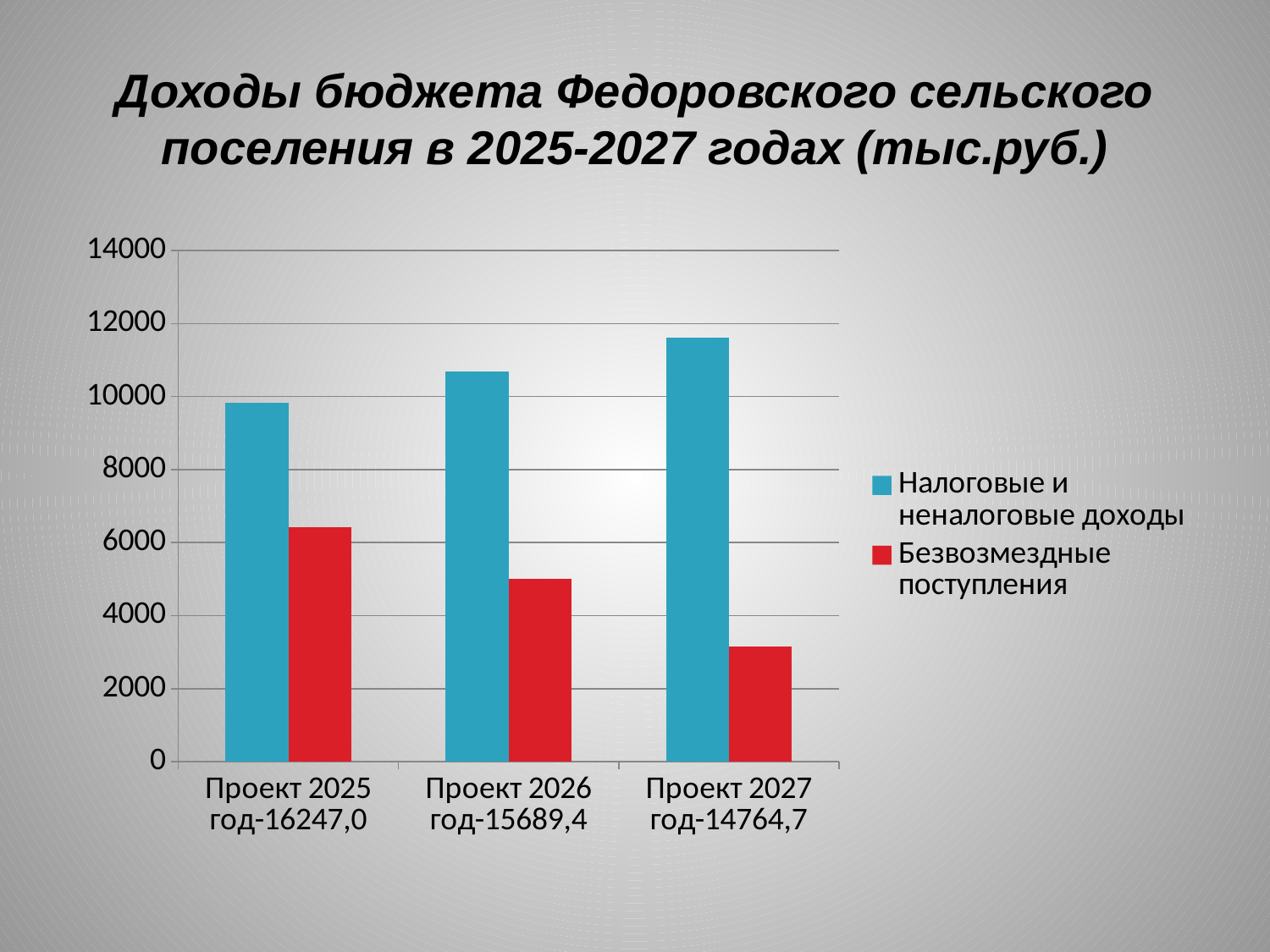
Do the values for Безвозмездные поступления rise or fall from Проект 2025 год to Проект 2027 год? fall Which category has the lowest value for Безвозмездные поступления? Проект 2027 год-14764,7 What total amount is printed in the x-axis label for Проект 2026 год? 15689,4 Which category has the highest value for Налоговые и неналоговые доходы? Проект 2027 год-14764,7 Is the value for Налоговые и неналоговые доходы in Проект 2026 год greater or less than 10000? greater What kind of chart is shown on the slide? Bar chart Is the value for Безвозмездные поступления in Проект 2027 год greater or less than 4000? less What colour represents Безвозмездные поступления in the legend? Red How many series does the legend list? 2 How many categories are shown on the x axis? 3 Which is larger for Проект 2025 год: Налоговые и неналоговые доходы or Безвозмездные поступления? Налоговые и неналоговые доходы Do the values for Налоговые и неналоговые доходы rise or fall from Проект 2025 год to Проект 2027 год? rise